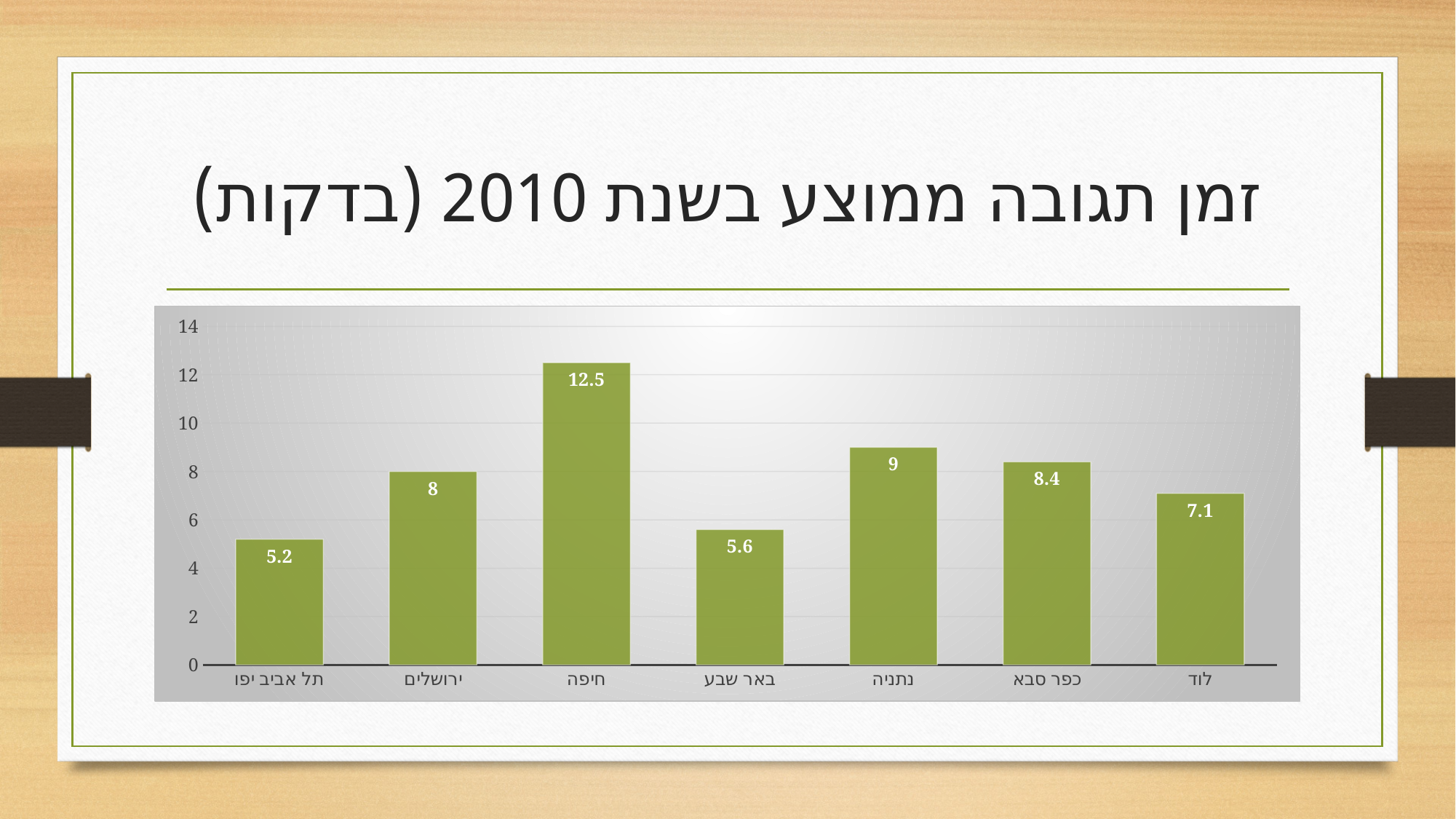
What is the difference between the values for נתניה and ירושלים? 1 Which category has the highest value? חיפה What kind of chart is shown on the slide? bar chart How many categories are shown on the x axis? 7 Is the value for נתניה greater or less than 10? less Which category has the lowest value? תל אביב יפו What is the title of the slide? זמן תגובה ממוצע בשנת 2010 (בדקות) What is the value for חיפה? 12.5 What is the value for תל אביב יפו? 5.2 What is the value for כפר סבא? 8.4 Which is larger, the value for באר שבע or the value for לוד? לוד What is the difference between the values for חיפה and לוד? 5.4